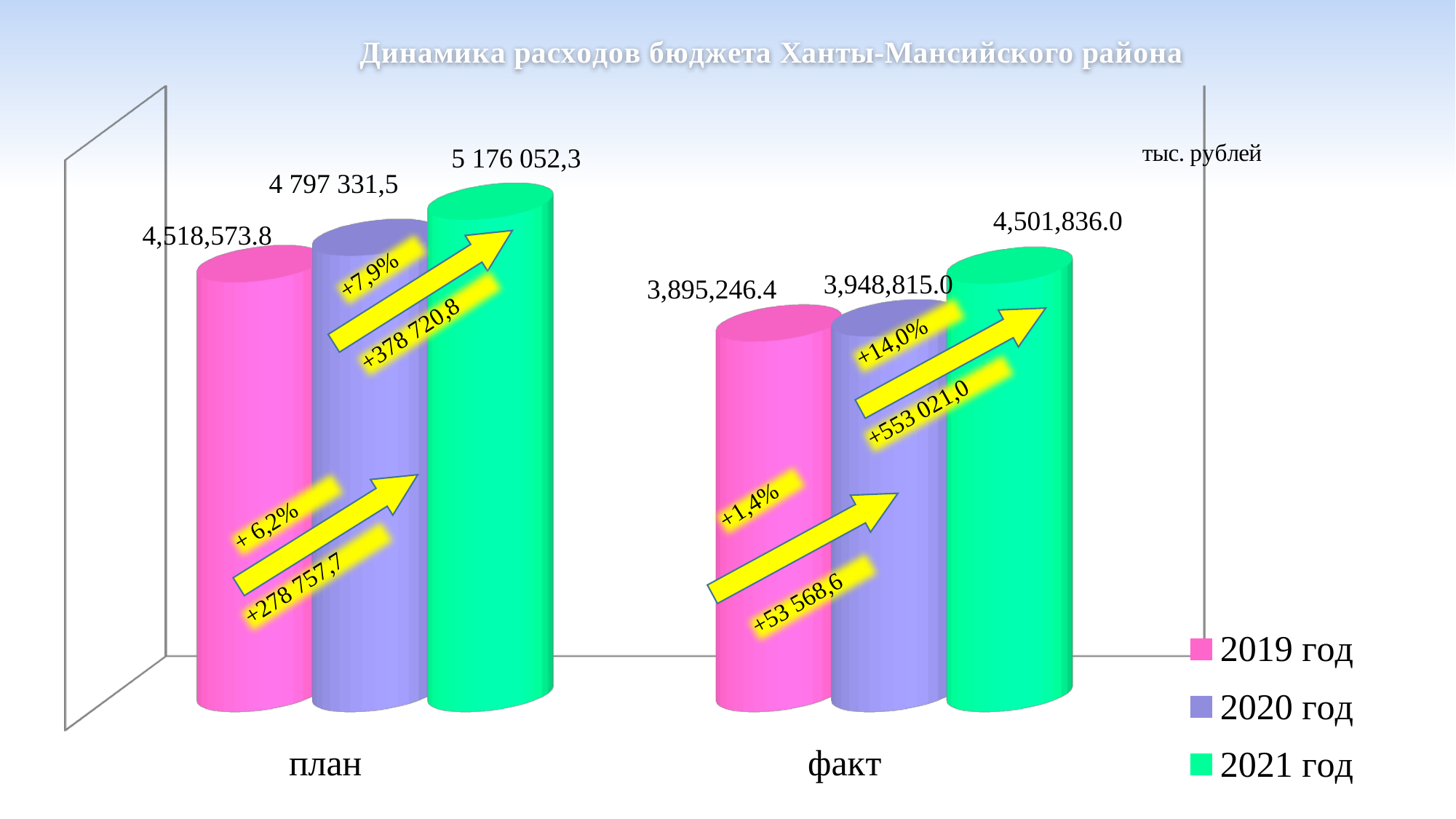
What is the value for 2021 год in the факт category? 4,501,836.0 How many series does the legend list? 3 What is the title of the chart? Динамика расходов бюджета Ханты-Мансийского района Which year has the highest value in the факт category? 2021 год Which is larger: the 2021 год value for план or the 2021 год value for факт? план What is the value for 2019 год in the факт category? 3,895,246.4 What is the value for 2019 год in the план category? 4,518,573.8 What is the difference between the 2021 год and 2020 год values in the факт category, as labelled on the chart? +553 021,0 What is the value for 2021 год in the план category? 5 176 052,3 What kind of chart is shown on the slide? bar chart What is the value for 2020 год in the план category? 4 797 331,5 Which year has the lowest value in the план category? 2019 год